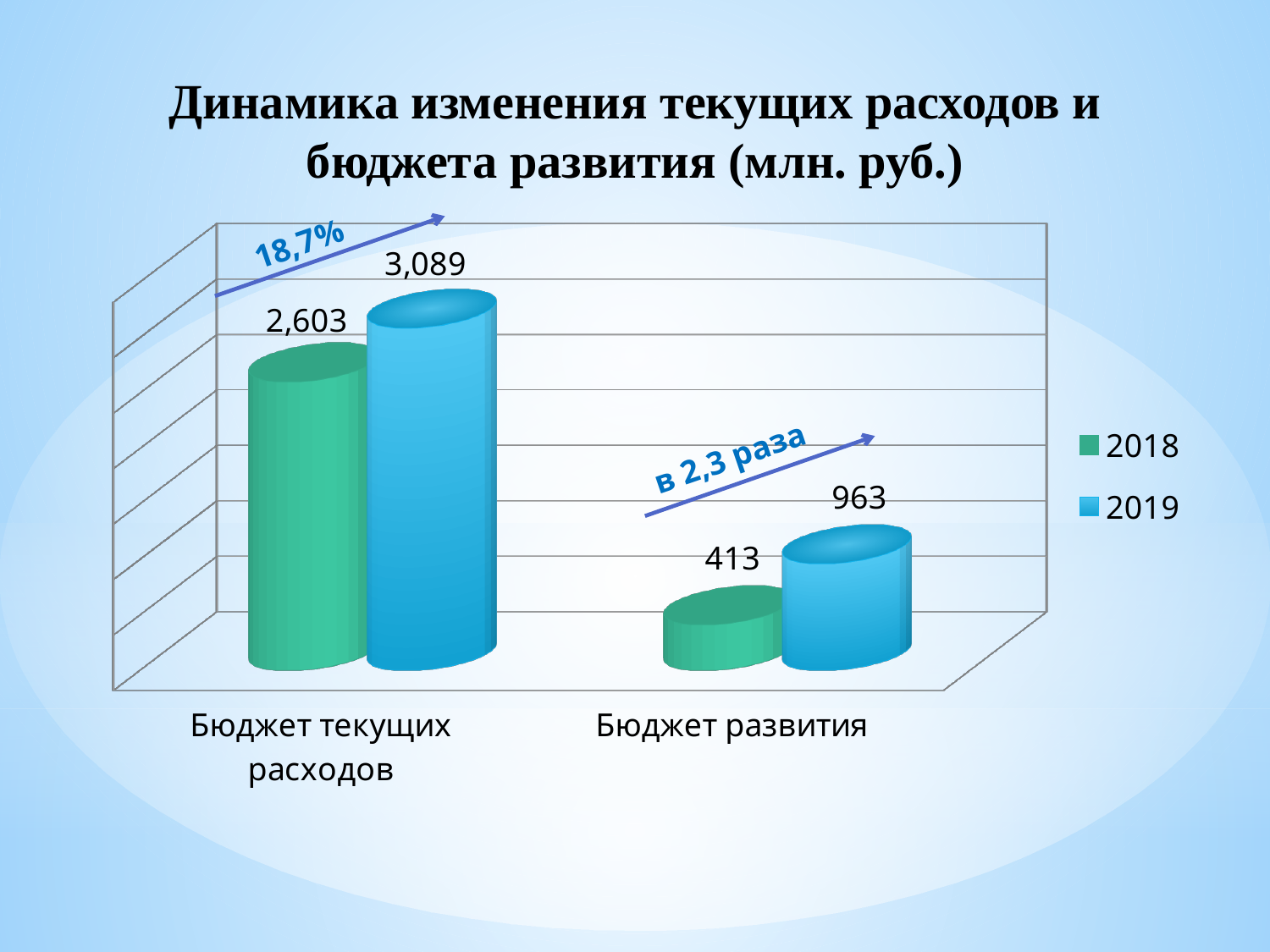
What is the value for Бюджет текущих расходов in 2019? 3,089 What is the difference between the 2019 and 2018 values for Бюджет развития? 550 Which bar has the lowest value on the chart? Бюджет развития, 2018 Which is larger: Бюджет развития in 2019 or Бюджет текущих расходов in 2018? Бюджет текущих расходов in 2018 What is the value for Бюджет развития in 2019? 963 What is the value for Бюджет развития in 2018? 413 What kind of chart is shown on the slide? Bar chart What is the difference between the 2019 and 2018 values for Бюджет текущих расходов? 486 What percentage growth is annotated above the Бюджет текущих расходов bars? 18,7% Which bar has the highest value on the chart? Бюджет текущих расходов, 2019 What is the value for Бюджет текущих расходов in 2018? 2,603 How many series does the legend list? 2